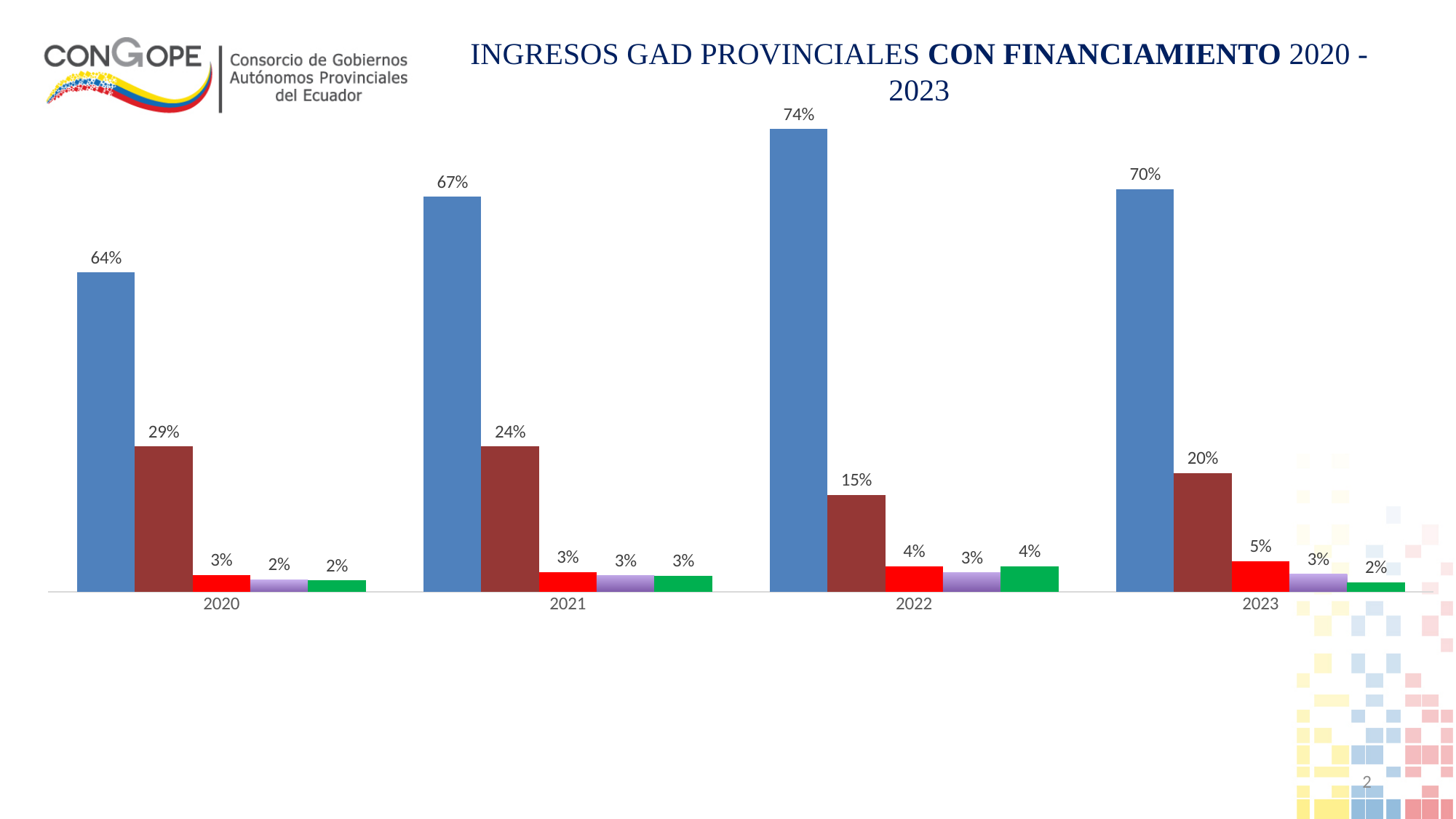
What is the value of the red bar for 2023? 5% What is the difference between the blue bar values for 2022 and 2020? 10% In which year is the dark red bar lowest? 2022 What is the title of the chart? INGRESOS GAD PROVINCIALES CON FINANCIAMIENTO 2020 - 2023 What is the value of the dark red bar for 2020? 29% Which is larger, the dark red bar for 2021 or the dark red bar for 2023? 2021 What kind of chart is shown on the slide? Bar chart In which year is the blue bar highest? 2022 How many years are shown on the x axis? 4 What is the value of the green bar for 2021? 3% Does the dark red bar rise or fall from 2020 to 2022? Fall What is the value of the blue bar for 2022? 74%